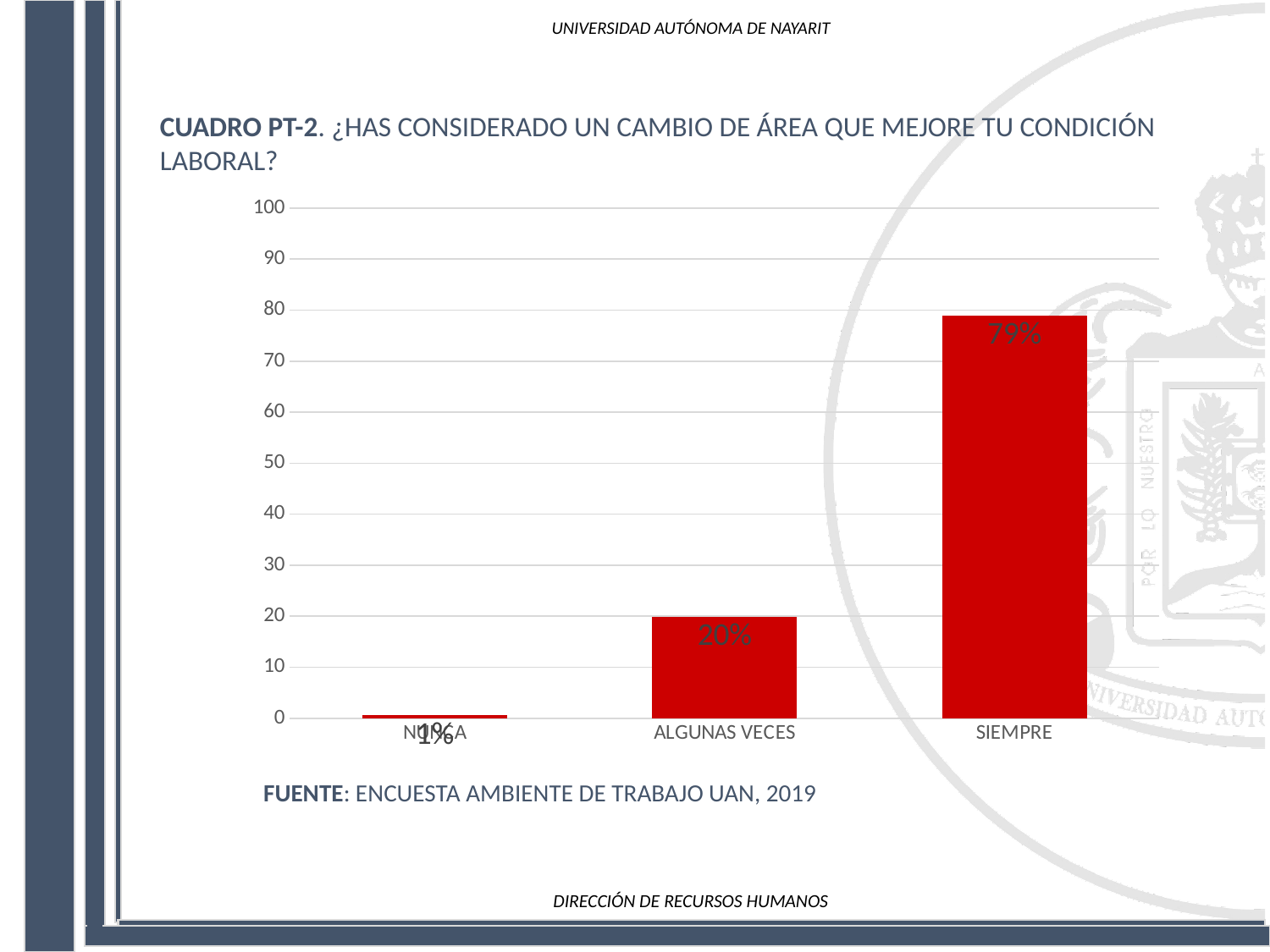
What is the value for NUNCA? 1% What is the value for SIEMPRE? 79% What kind of chart is shown on the slide? bar chart Which category has the lowest value? NUNCA What is the value for ALGUNAS VECES? 20% What source is cited below the chart? ENCUESTA AMBIENTE DE TRABAJO UAN, 2019 What is the difference between the values for SIEMPRE and ALGUNAS VECES? 59% What is the difference between the values for ALGUNAS VECES and NUNCA? 19% Is the value for SIEMPRE greater or less than 70? greater Which category has the highest value? SIEMPRE How many categories are shown on the x axis? 3 Which is larger, the value for ALGUNAS VECES or the value for SIEMPRE? SIEMPRE